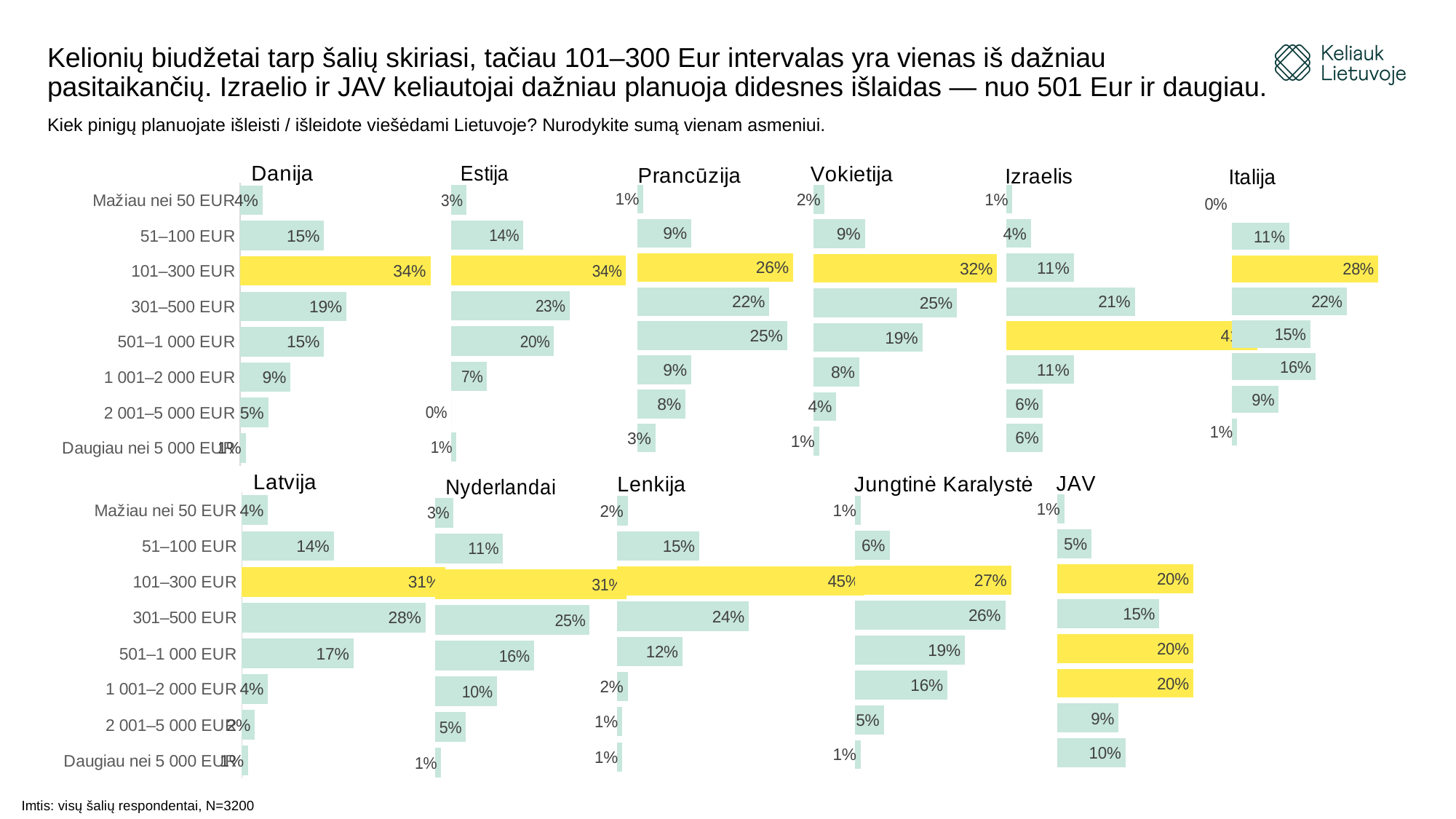
In the Italija chart, which budget category has the lowest value? Mažiau nei 50 EUR In the Danija chart, what percentage of respondents chose 101–300 EUR? 34% In the Prancūzija chart, which budget category has the highest value? 101–300 EUR How many country charts are shown on the slide? 11 In the JAV chart, what percentage is shown for Daugiau nei 5 000 EUR? 10% In the Estija chart, which is larger: the value for 301–500 EUR or the value for 501–1 000 EUR? 301–500 EUR In the Jungtinė Karalystė chart, what is the value for 1 001–2 000 EUR? 16% How many budget categories are shown in the Latvija chart? 8 In the Nyderlandai chart, what is the difference between the 301–500 EUR value and the 501–1 000 EUR value? 9% What type of chart is used for each country on this slide? Bar chart In the Vokietija chart, what is the difference between the 101–300 EUR value and the 301–500 EUR value? 7% In the Lenkija chart, what is the value for 101–300 EUR? 45%